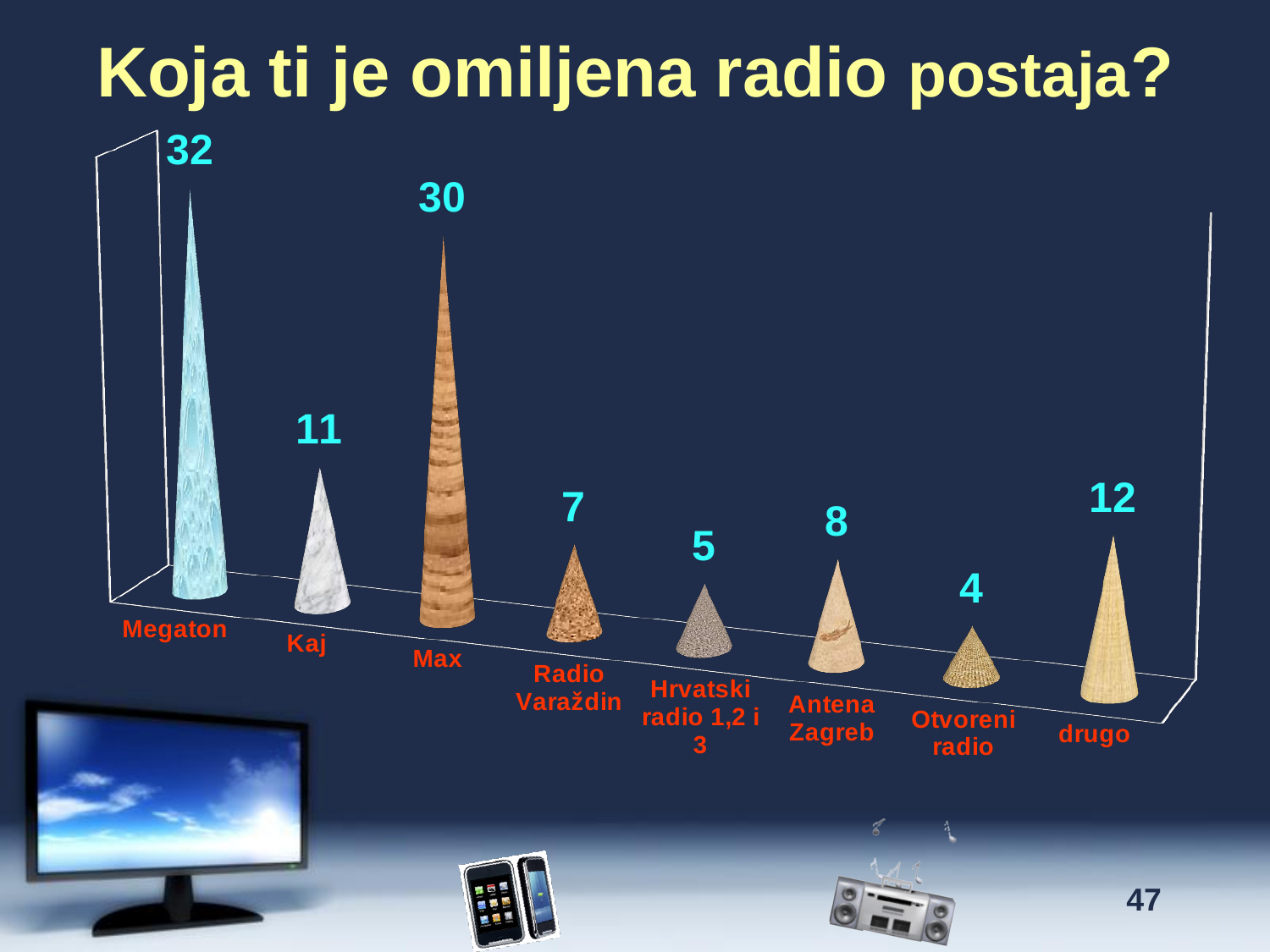
Which is larger, the value for Antena Zagreb or the value for Radio Varaždin? Antena Zagreb What is the difference between the values for Megaton and Max? 2 Which category has the lowest value? Otvoreni radio Which radio station has the highest value? Megaton How many categories are shown in the chart? 8 What is the value for Otvoreni radio? 4 What is the difference between the values for drugo and Kaj? 1 What is the title of the slide? Koja ti je omiljena radio postaja? What is the value for Megaton? 32 What kind of chart is shown on the slide? bar chart What is the value for Max? 30 What is the value for drugo? 12